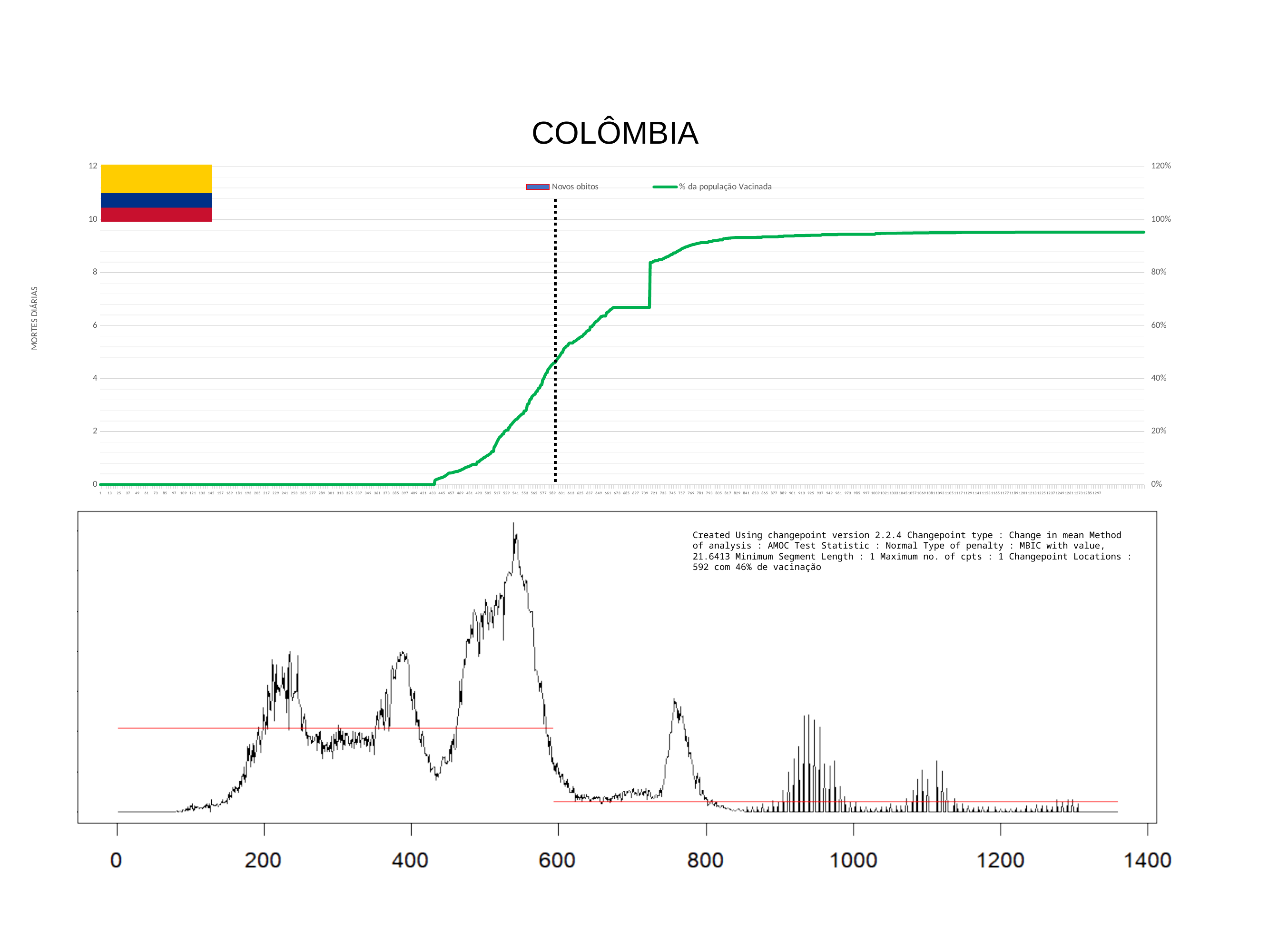
In the bottom chart, at what location does the annotation say the changepoint occurs? 592 In the top chart, what are the two legend entries? Novos obitos; % da população Vacinada What is the title of the slide? COLÔMBIA In the top chart, is the value of '% da população Vacinada' at x = 697 greater or less than 60%? greater In the top chart, what is the highest tick value shown on the right vertical axis? 120% In the top chart, how many series does the legend list? 2 In the top chart, does the green '% da população Vacinada' line rise or fall along the x axis overall? rise In the top chart, is the value of '% da população Vacinada' at the far right end of the x axis greater or less than 80%? greater In the top chart, is the value of '% da população Vacinada' at x = 433 greater or less than 20%? less In the bottom chart, what percentage of vaccination does the annotation associate with the changepoint? 46%